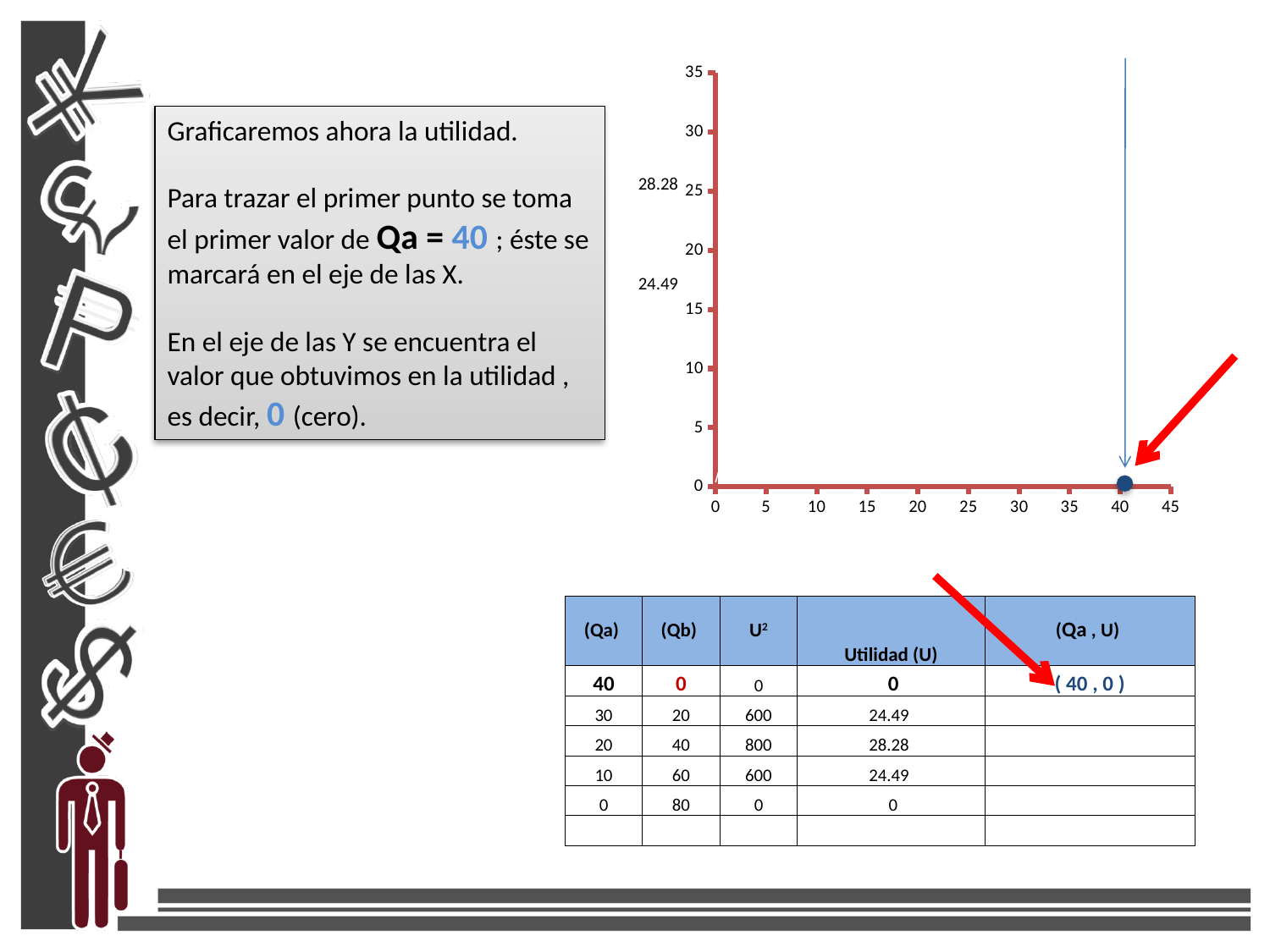
How many tick labels are shown on the x axis of the chart? 10 What is the highest tick value shown on the x axis of the chart? 45 How many data points are plotted on the chart? 1 Is the x-axis value of the plotted point greater or less than 35? greater What is the x-axis value of the plotted point on the chart? 40 Is the y-axis value of the plotted point greater or less than 5? less What is the y-axis value of the plotted point on the chart? 0 What is the highest tick value shown on the y axis of the chart? 35 What kind of chart is shown on the slide? scatter chart